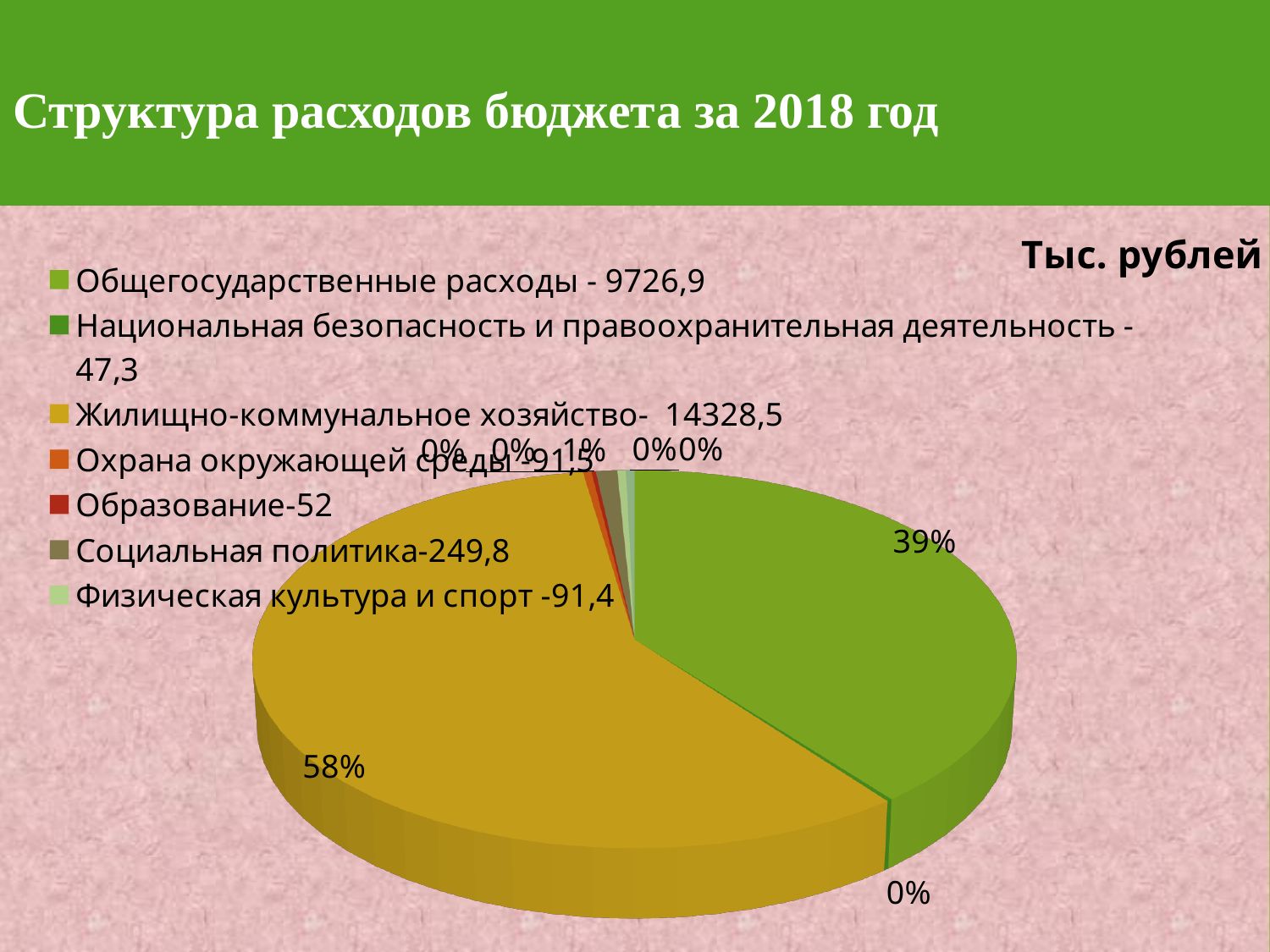
What is the value for Социальная политика? 249,8 What is the value for Образование? 52 How many categories does the legend of the pie chart list? 7 What share of the pie does Жилищно-коммунальное хозяйство take? 58% What is the value for Жилищно-коммунальное хозяйство? 14328,5 What is the title of the chart on the slide? Тыс. рублей What share of the pie does Общегосударственные расходы take? 39% Which category has the smallest value? Национальная безопасность и правоохранительная деятельность Which category has the largest share of the pie? Жилищно-коммунальное хозяйство What is the difference between the values for Жилищно-коммунальное хозяйство and Общегосударственные расходы? 4601,6 What kind of chart is shown on the slide? pie chart What is the value for Общегосударственные расходы? 9726,9